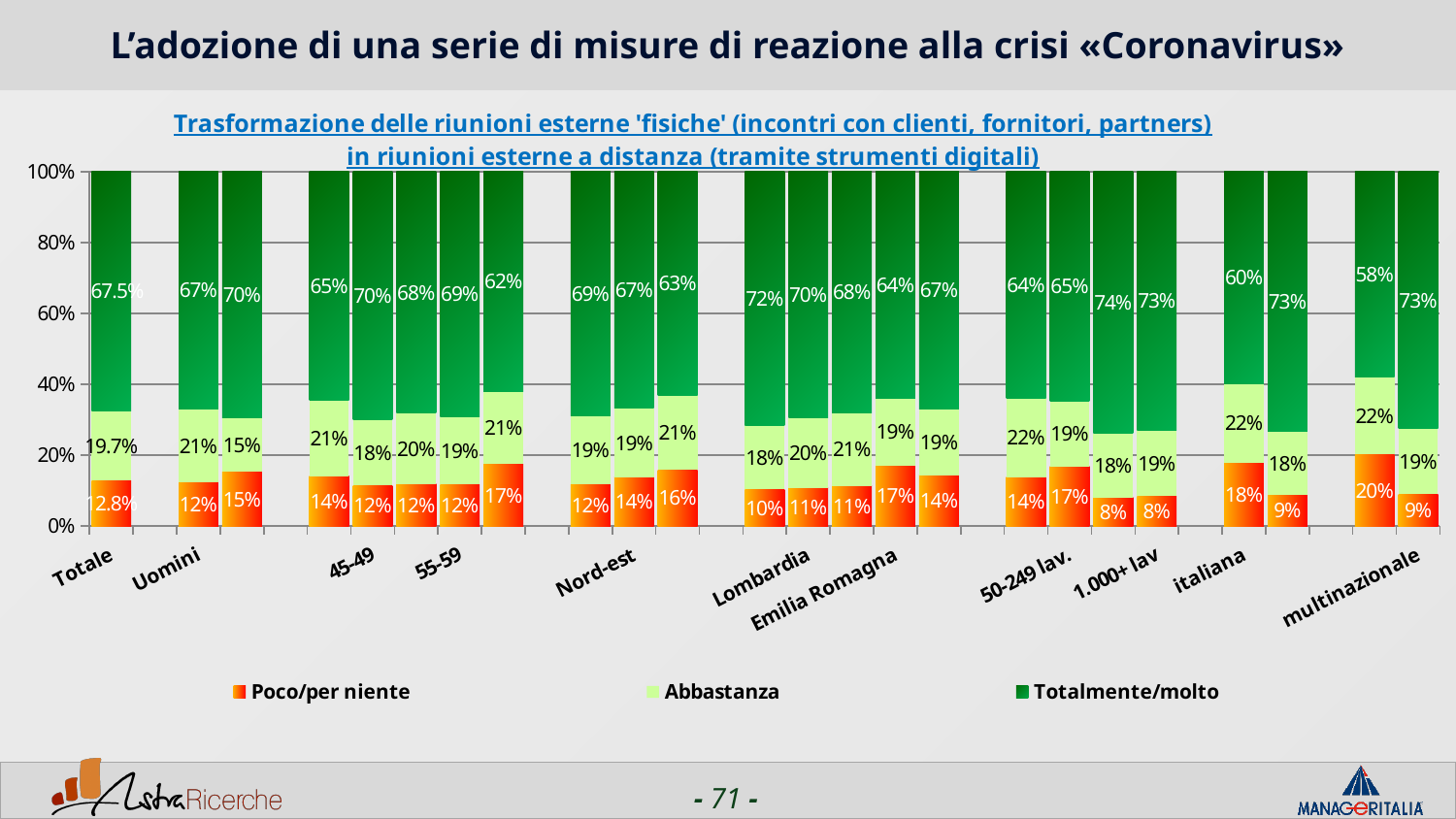
What is the Poco/per niente value for 1.000+ lav? 8% What is the Totalmente/molto value for Totale? 67.5% What are the three legend entries of the chart? Poco/per niente, Abbastanza, Totalmente/molto Which has the larger Totalmente/molto value, Lombardia or Emilia Romagna? Lombardia What is the Poco/per niente value for Nord-est? 14% What kind of chart is shown on the slide? Stacked bar chart What is the difference between the Totalmente/molto values for 45-49 and 55-59? 1 percentage point What is the Totalmente/molto value for Lombardia? 70% What is the Poco/per niente value for Totale? 12.8% What is the Abbastanza value for Uomini? 21% How many series does the legend list? 3 What is the Abbastanza value for 50-249 lav.? 19%